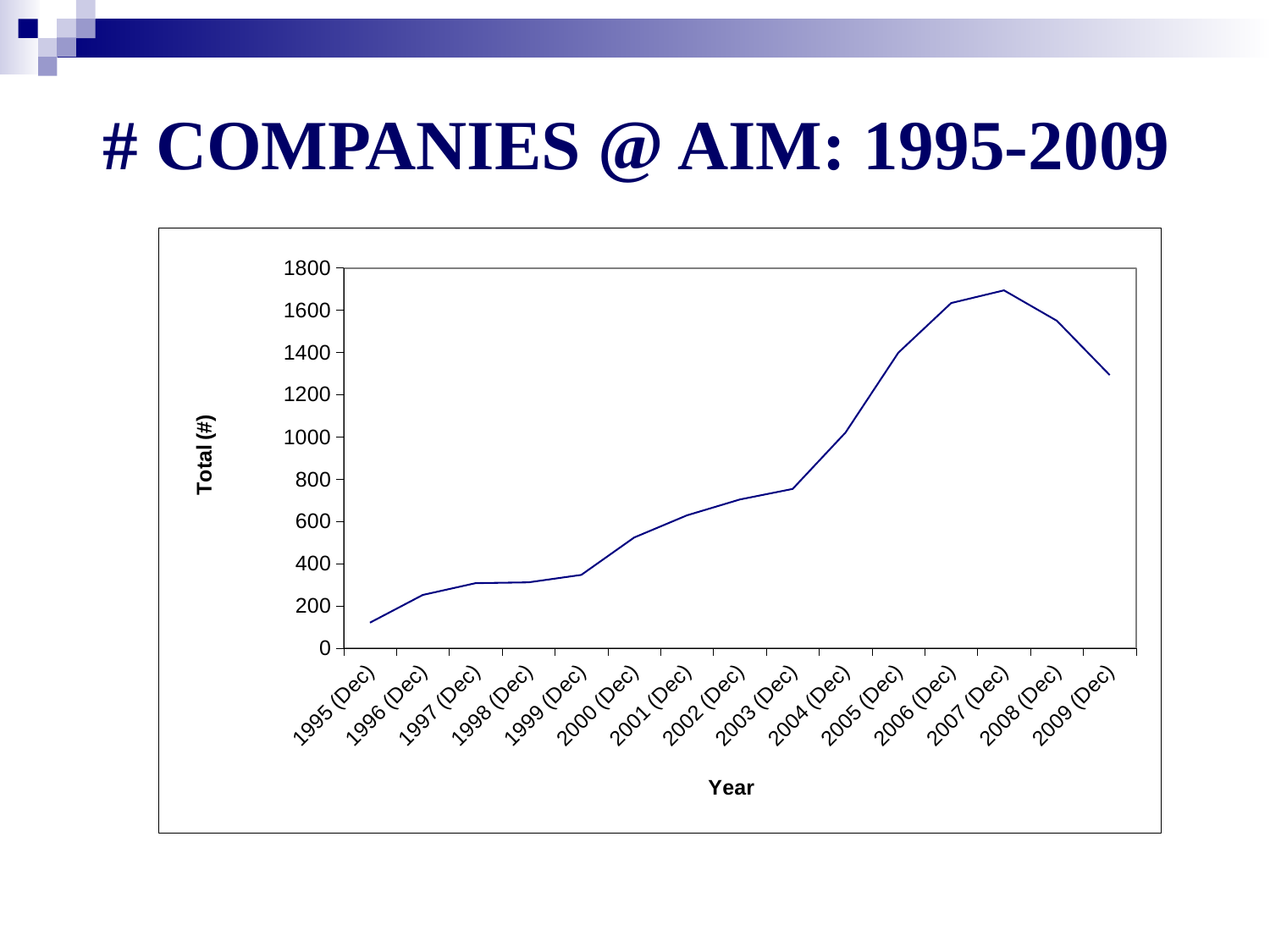
Do the values rise or fall from 1995 (Dec) to 2007 (Dec)? rise What kind of chart is shown on the slide? line chart Which year has the larger value, 2004 (Dec) or 2009 (Dec)? 2009 (Dec) Is the value for 2000 (Dec) greater or less than 400? greater What is the label of the vertical axis? Total (#) In which year is the total number of companies highest? 2007 (Dec) Is the value for 1995 (Dec) greater or less than 200? less Is the value for 2009 (Dec) greater or less than 1200? greater In which year is the total number of companies lowest? 1995 (Dec) How many data points (years) are plotted on the chart? 15